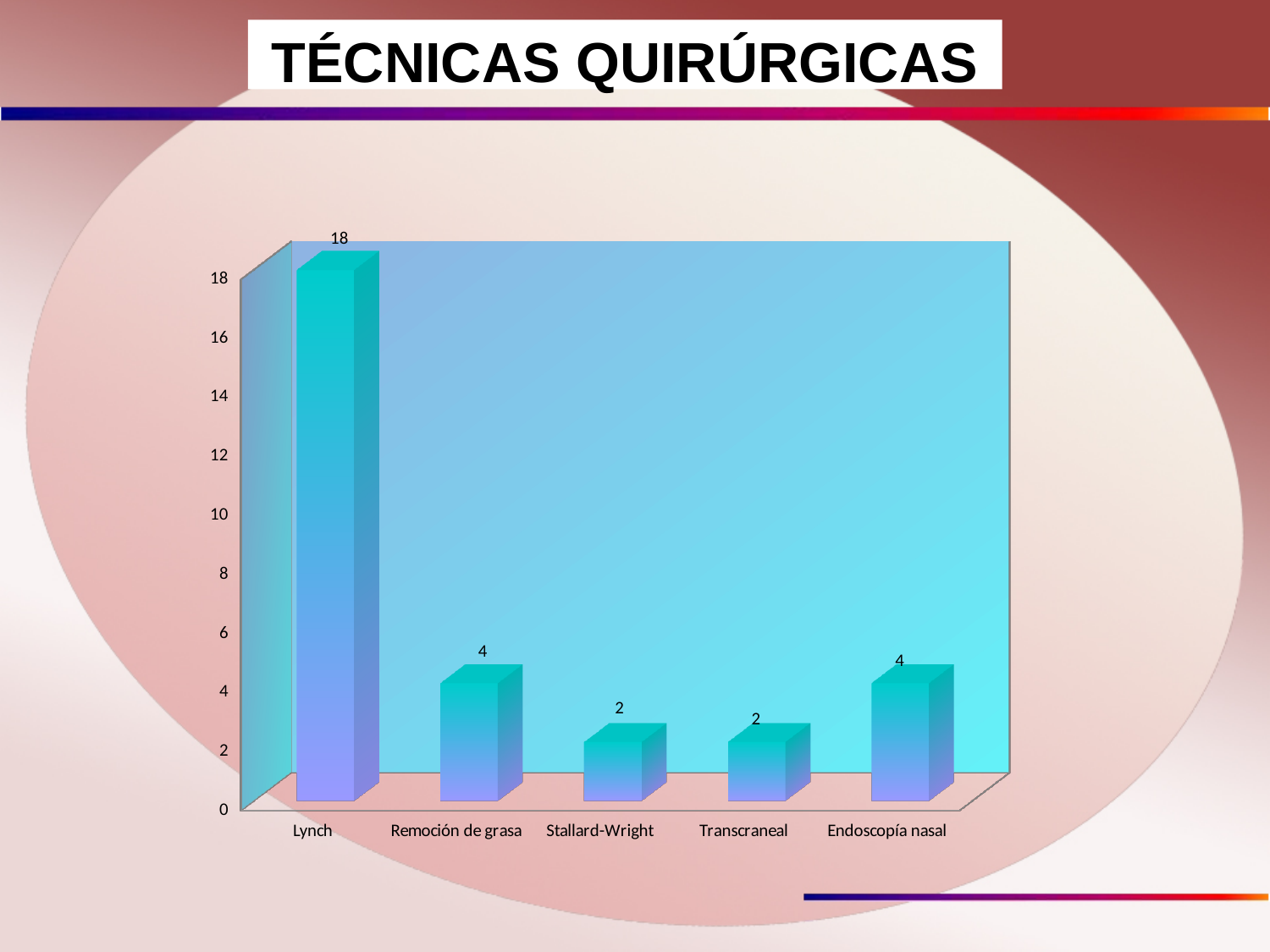
What kind of chart is shown on the slide? bar chart What is the value for Stallard-Wright? 2 Which is larger, the value for Transcraneal or the value for Endoscopía nasal? Endoscopía nasal How many categories are shown on the x axis? 5 What is the difference between the values for Remoción de grasa and Stallard-Wright? 2 What is the value for Lynch? 18 What is the value for Remoción de grasa? 4 What is the value for Endoscopía nasal? 4 What is the difference between the values for Lynch and Remoción de grasa? 14 Is the value for Lynch greater or less than 10? greater What is the title of the slide? TÉCNICAS QUIRÚRGICAS Which category has the highest value? Lynch